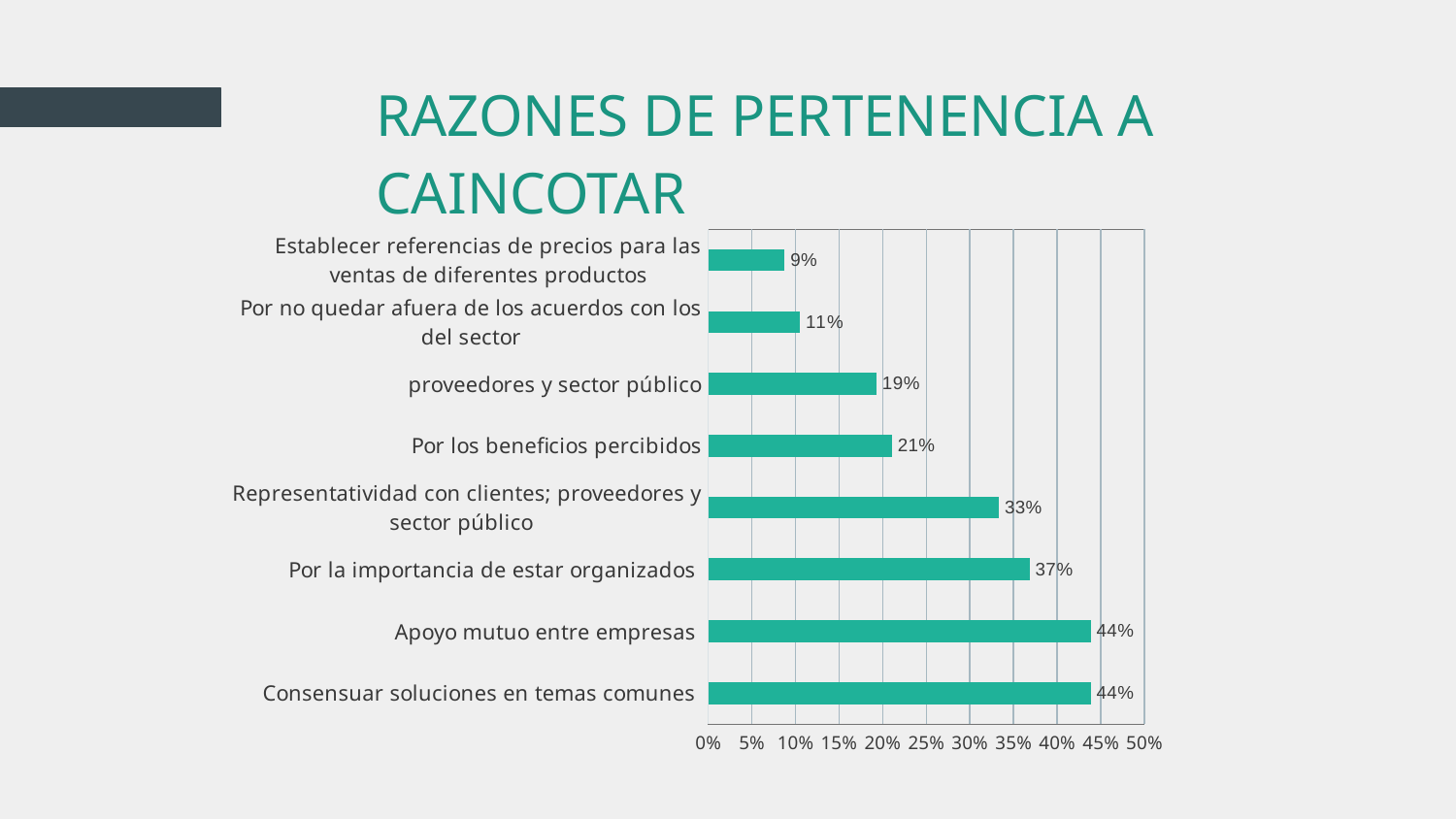
Which is larger: "proveedores y sector público" or "Por los beneficios percibidos"? Por los beneficios percibidos What is the value for "Por no quedar afuera de los acuerdos con los del sector"? 11% What is the value for "Por la importancia de estar organizados"? 37% What is the highest value shown in the chart? 44% How many categories are shown in the chart? 8 Is the value for "Representatividad con clientes; proveedores y sector público" greater or less than 30%? greater Which category has the lowest value? Establecer referencias de precios para las ventas de diferentes productos What kind of chart is shown on the slide? Bar chart What is the difference between "Apoyo mutuo entre empresas" and "Por la importancia de estar organizados"? 7% What is the value for "Por los beneficios percibidos"? 21% What is the title of the slide? RAZONES DE PERTENENCIA A CAINCOTAR What is the value for "Representatividad con clientes; proveedores y sector público"? 33%